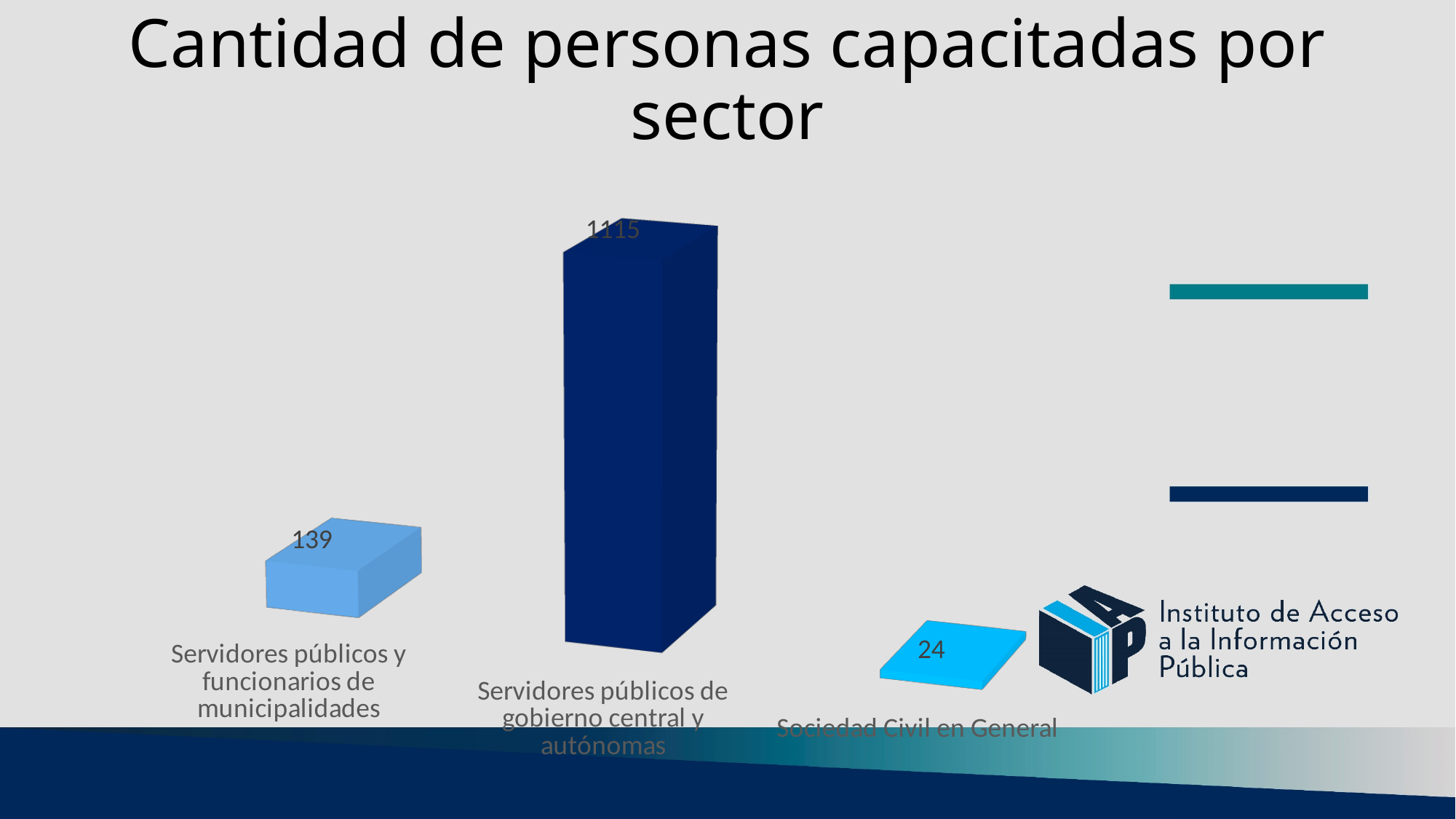
What kind of chart is shown on the slide? Bar chart What is the title of the chart? Cantidad de personas capacitadas por sector Which sector has the highest number of people trained? Servidores públicos de gobierno central y autónomas What colour is the bar for Servidores públicos de gobierno central y autónomas? Dark navy blue Which is larger: the value for Servidores públicos y funcionarios de municipalidades or for Sociedad Civil en General? Servidores públicos y funcionarios de municipalidades What is the difference between the values for Servidores públicos de gobierno central y autónomas and Servidores públicos y funcionarios de municipalidades? 976 What is the value for Servidores públicos y funcionarios de municipalidades? 139 How many sectors are shown in the chart? 3 What is the difference between the values for Servidores públicos y funcionarios de municipalidades and Sociedad Civil en General? 115 Which sector has the lowest number of people trained? Sociedad Civil en General What is the value for Servidores públicos de gobierno central y autónomas? 1115 What is the value for Sociedad Civil en General? 24